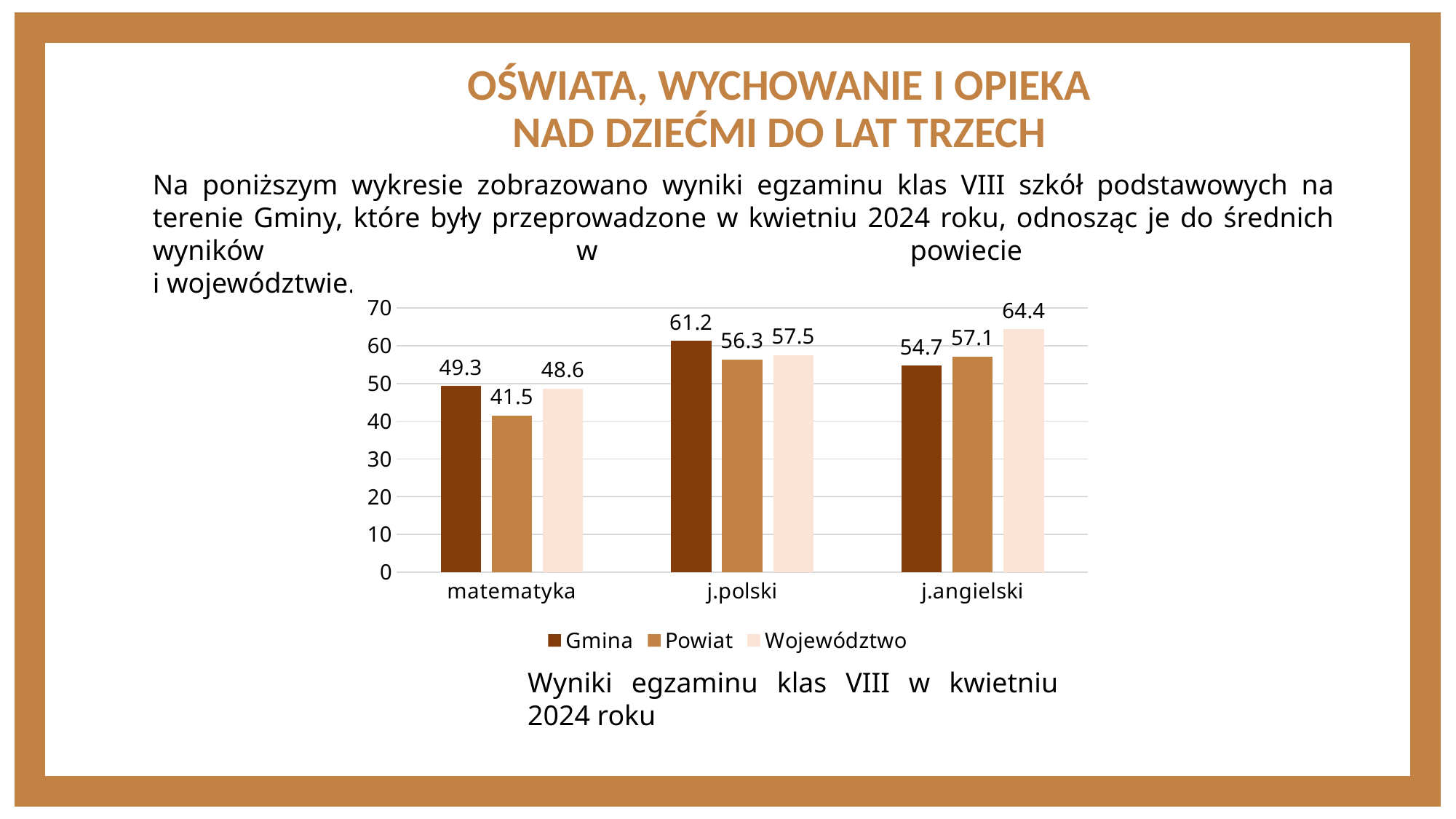
What is the title of the chart? Wyniki egzaminu klas VIII w kwietniu 2024 roku What is the difference between the Gmina and Powiat values for matematyka? 7.8 How many series does the legend list? 3 How many categories are shown on the x axis? 3 Which is larger for j.angielski, the Gmina value or the Województwo value? Województwo What kind of chart is shown on the slide? bar chart What is the Powiat value for j.polski? 56.3 Which category has the lowest Powiat value? matematyka What is the Gmina value for matematyka? 49.3 What is the Województwo value for j.angielski? 64.4 What is the difference between the Województwo values for j.angielski and j.polski? 6.9 Which category has the highest Gmina value? j.polski